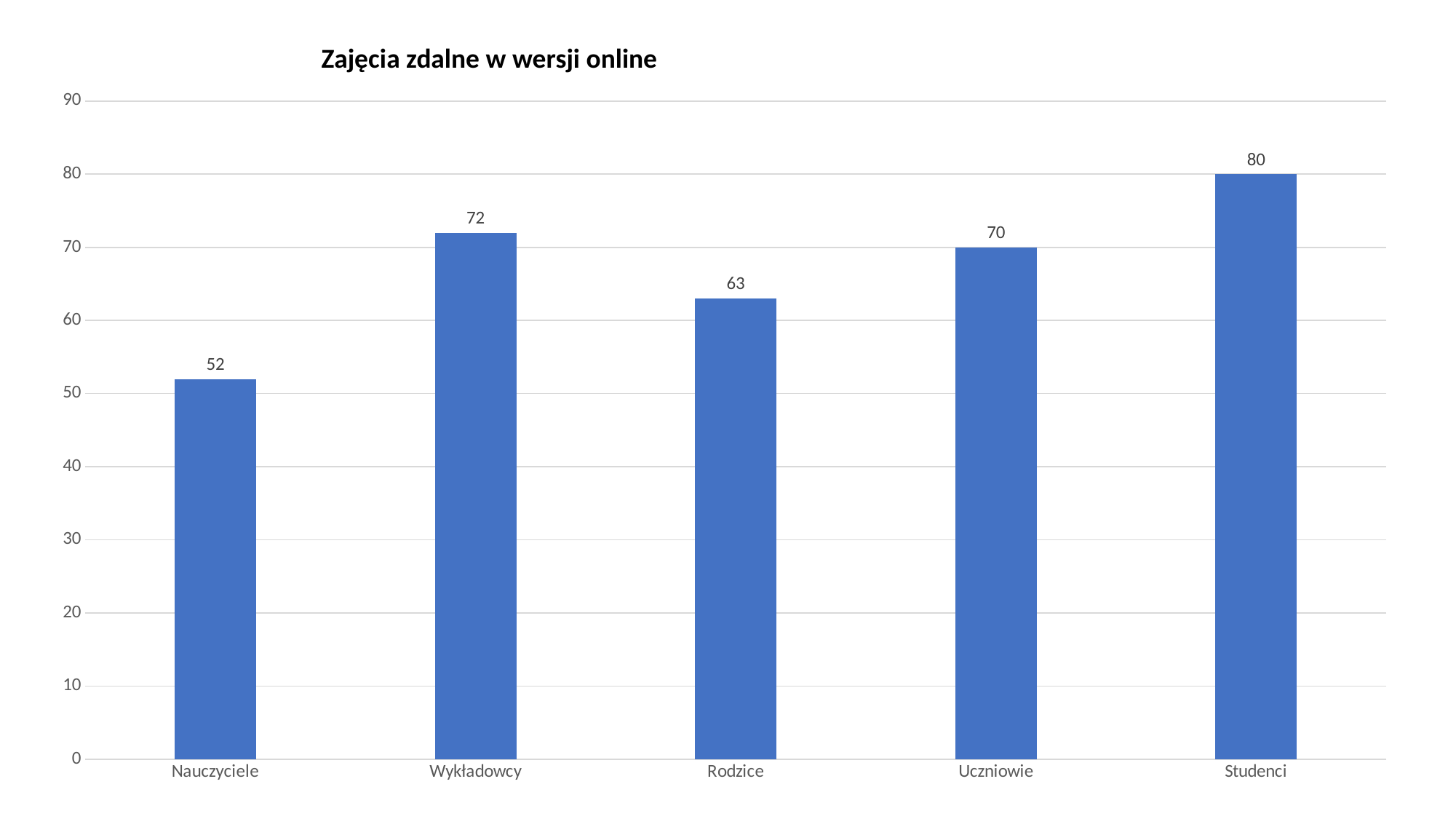
What is the difference between the values for Wykładowcy and Rodzice? 9 Which is larger, the value for Rodzice or the value for Uczniowie? Uczniowie What is the value for Rodzice? 63 What is the value for Wykładowcy? 72 Which category has the highest value? Studenci What is the title of the chart? Zajęcia zdalne w wersji online What is the value for Uczniowie? 70 What kind of chart is shown on the slide? Bar chart What is the value for Nauczyciele? 52 How many categories are shown on the chart? 5 What is the difference between the values for Studenci and Nauczyciele? 28 Which category has the lowest value? Nauczyciele